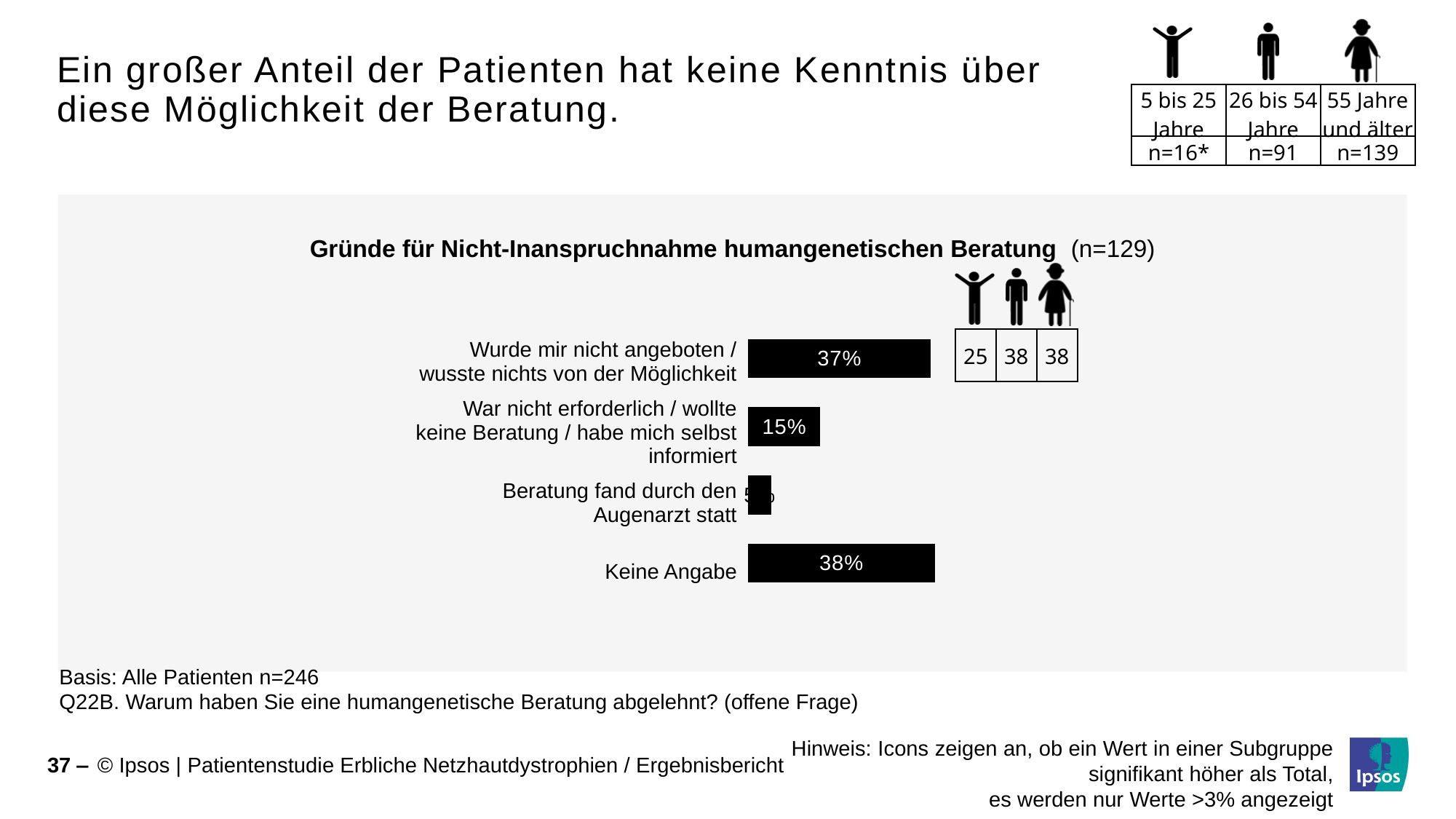
What percentage of respondents gave the reason "Wurde mir nicht angeboten / wusste nichts von der Möglichkeit"? 37% What type of chart is shown on the slide? Bar chart What is the value shown for "Keine Angabe"? 38% What is the difference in percentage points between "Keine Angabe" and "Wurde mir nicht angeboten / wusste nichts von der Möglichkeit"? 1 percentage point Which is larger: the value for "War nicht erforderlich / wollte keine Beratung / habe mich selbst informiert" or the value for "Keine Angabe"? Keine Angabe Which category has the lowest value in the chart? Beratung fand durch den Augenarzt statt In the subgroup table next to the first bar, what value is shown for the 26 bis 54 Jahre group? 38 Which category has the highest value in the chart? Keine Angabe How many reason categories are shown in the chart? 4 What is the title of the chart? Gründe für Nicht-Inanspruchnahme humangenetischen Beratung What is the difference in percentage points between "Wurde mir nicht angeboten / wusste nichts von der Möglichkeit" and "War nicht erforderlich / wollte keine Beratung / habe mich selbst informiert"? 22 percentage points What percentage is shown for "War nicht erforderlich / wollte keine Beratung / habe mich selbst informiert"? 15%